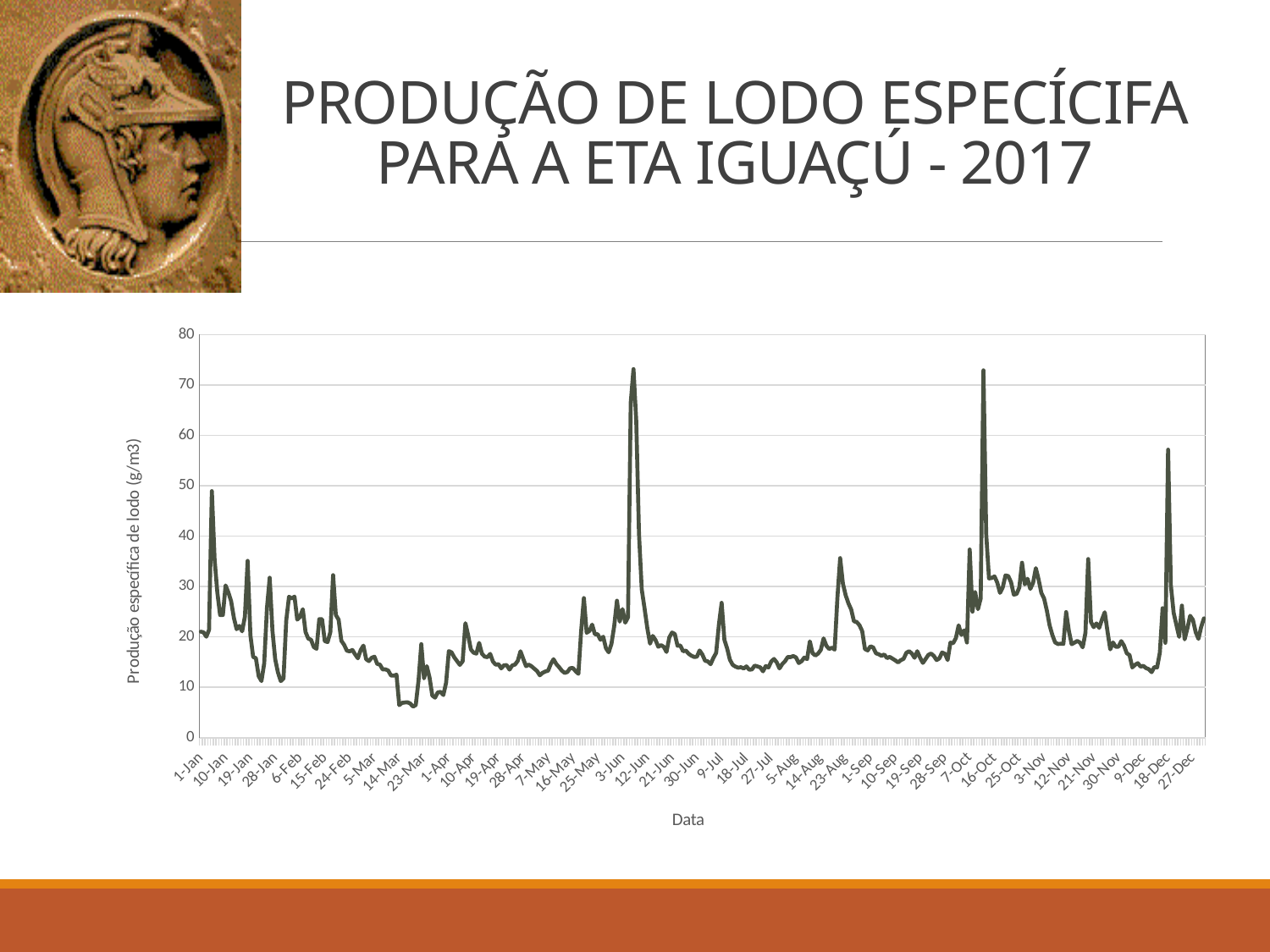
Is the peak value of the line near 18-Dec greater or less than 50? greater Is the value of the line around 18-Jul greater or less than 20? less Is the peak near 12-Jun higher or lower than the peak near 18-Dec? higher Is the peak value of the line in early January (near 1-Jan to 10-Jan) greater or less than 40? greater What is the maximum value shown on the vertical axis of the chart? 80 What is the title of the chart on the slide? PRODUÇÃO DE LODO ESPECÍCIFA PARA A ETA IGUAÇÚ - 2017 What kind of chart is shown on the slide? line chart What is the label of the vertical axis of the chart? Produção específica de lodo (g/m3)